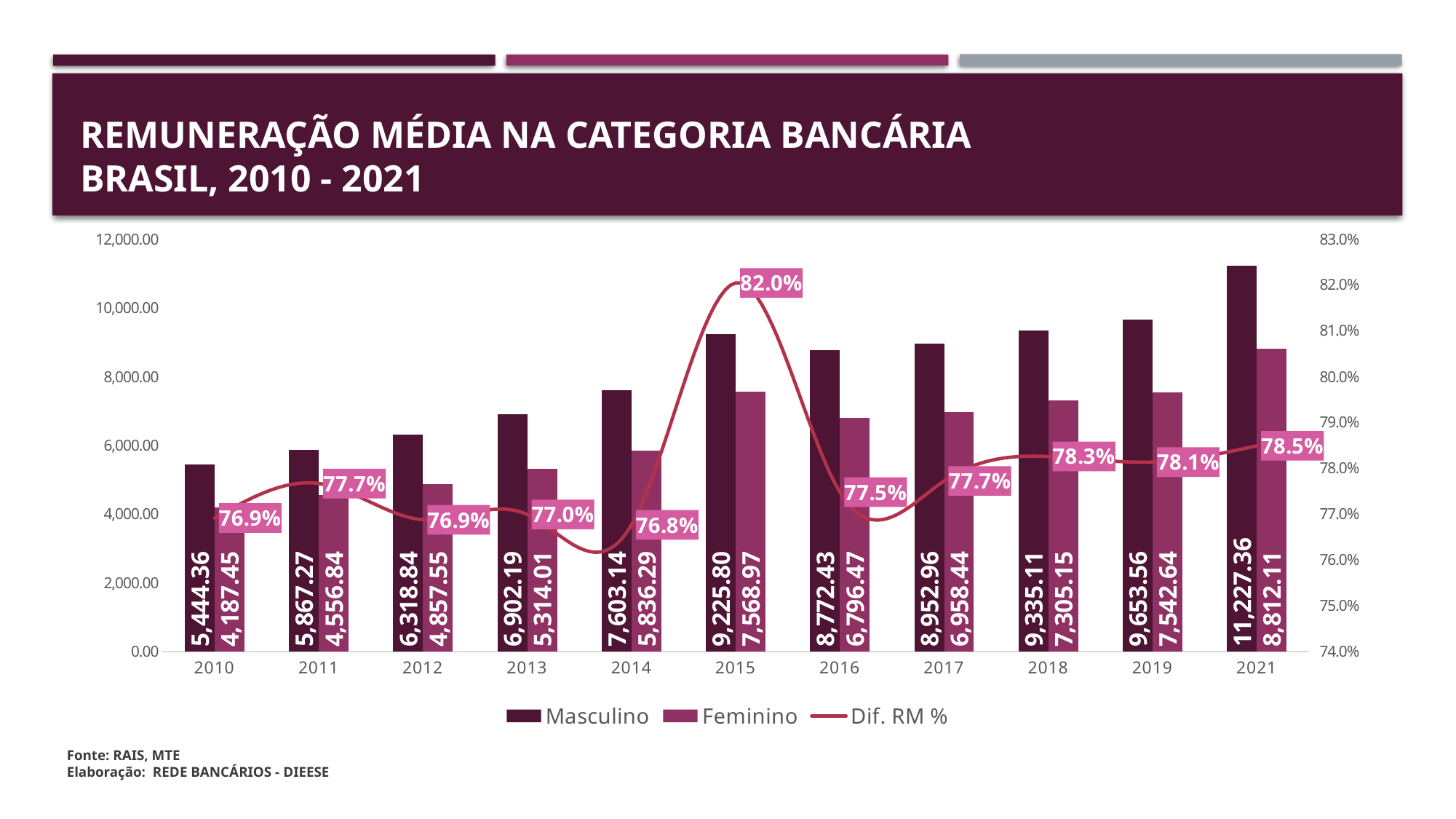
Which is larger, the Masculino value for 2015 or the Masculino value for 2016? 2015 What is the title of the chart? REMUNERAÇÃO MÉDIA NA CATEGORIA BANCÁRIA BRASIL, 2010 - 2021 In which year is the Feminino value lowest? 2010 How many series does the legend list? 3 What is the difference between the Masculino and Feminino values in 2021? 2,415.25 In which year is the Dif. RM % line at its highest? 2015 Does the Masculino value rise or fall from 2010 to 2014? Rise What is the Feminino value for 2021? 8,812.11 What is the Dif. RM % value for 2018? 78.3% What kind of chart is used for the Masculino and Feminino series? Bar chart How many years are shown on the x axis? 11 What is the Masculino value for 2015? 9,225.80